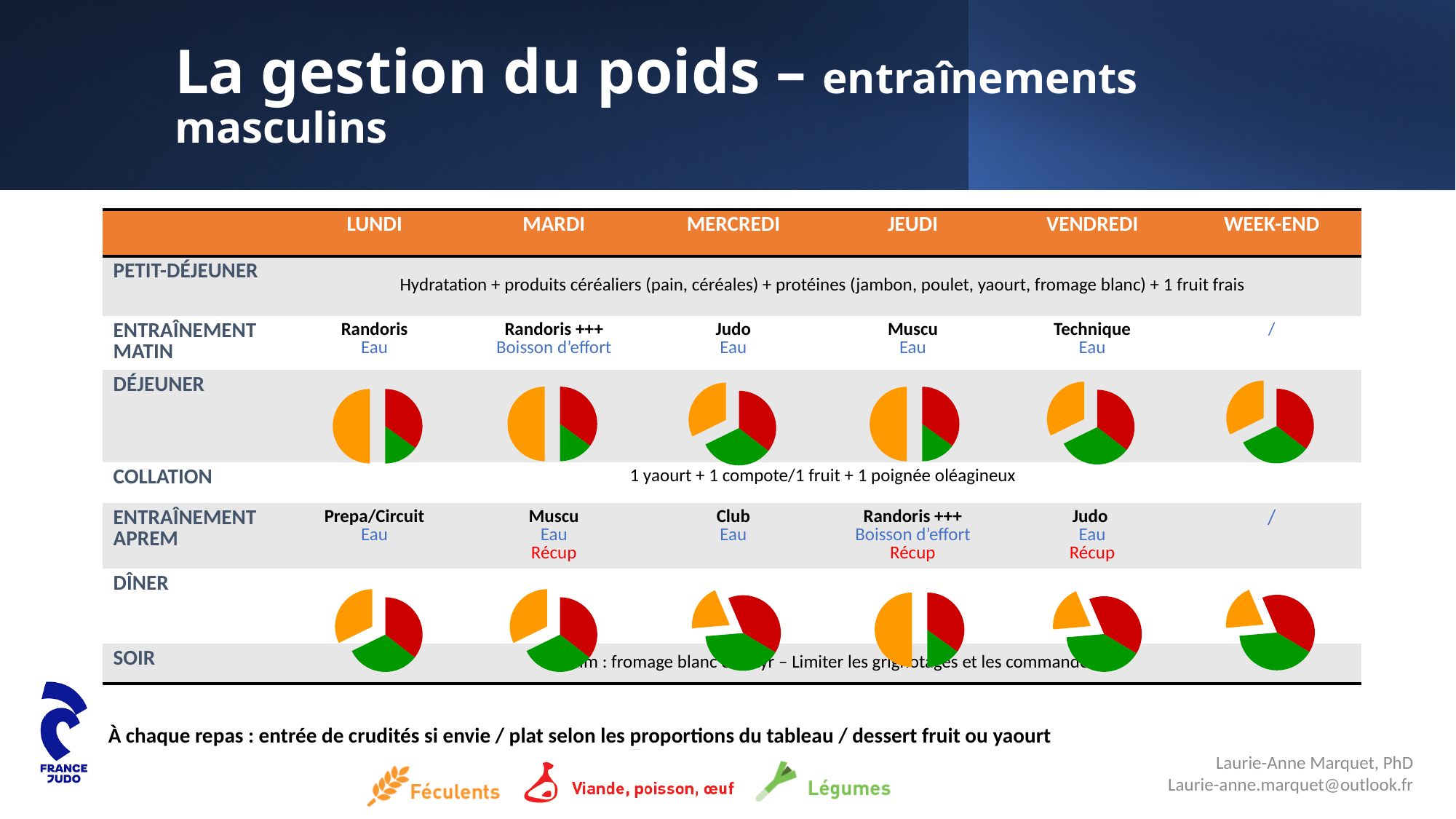
According to the legend, which colour represents Légumes in the pie charts? Green According to the legend, which food category is shown in red in the pie charts? Viande, poisson, œuf In the DÎNER pie chart for JEUDI, which food category has the largest slice? Féculents How many food categories does the legend at the bottom of the slide list? 3 How many pie charts are shown on the slide in total? 12 How many slices does each pie chart on the slide contain? 3 In the DÎNER pie chart for MERCREDI, which food category has the smallest slice? Féculents In the DÉJEUNER pie chart for JEUDI, which slice is larger: Féculents or Légumes? Féculents In the DÉJEUNER pie chart for LUNDI, which food category has the largest slice? Féculents What kind of chart is used in the DÉJEUNER and DÎNER rows of the table? Pie chart In the DÉJEUNER pie chart for LUNDI, which food category has the smallest slice? Légumes In the DÎNER pie chart for WEEK-END, which slice is larger: Féculents or Légumes? Légumes